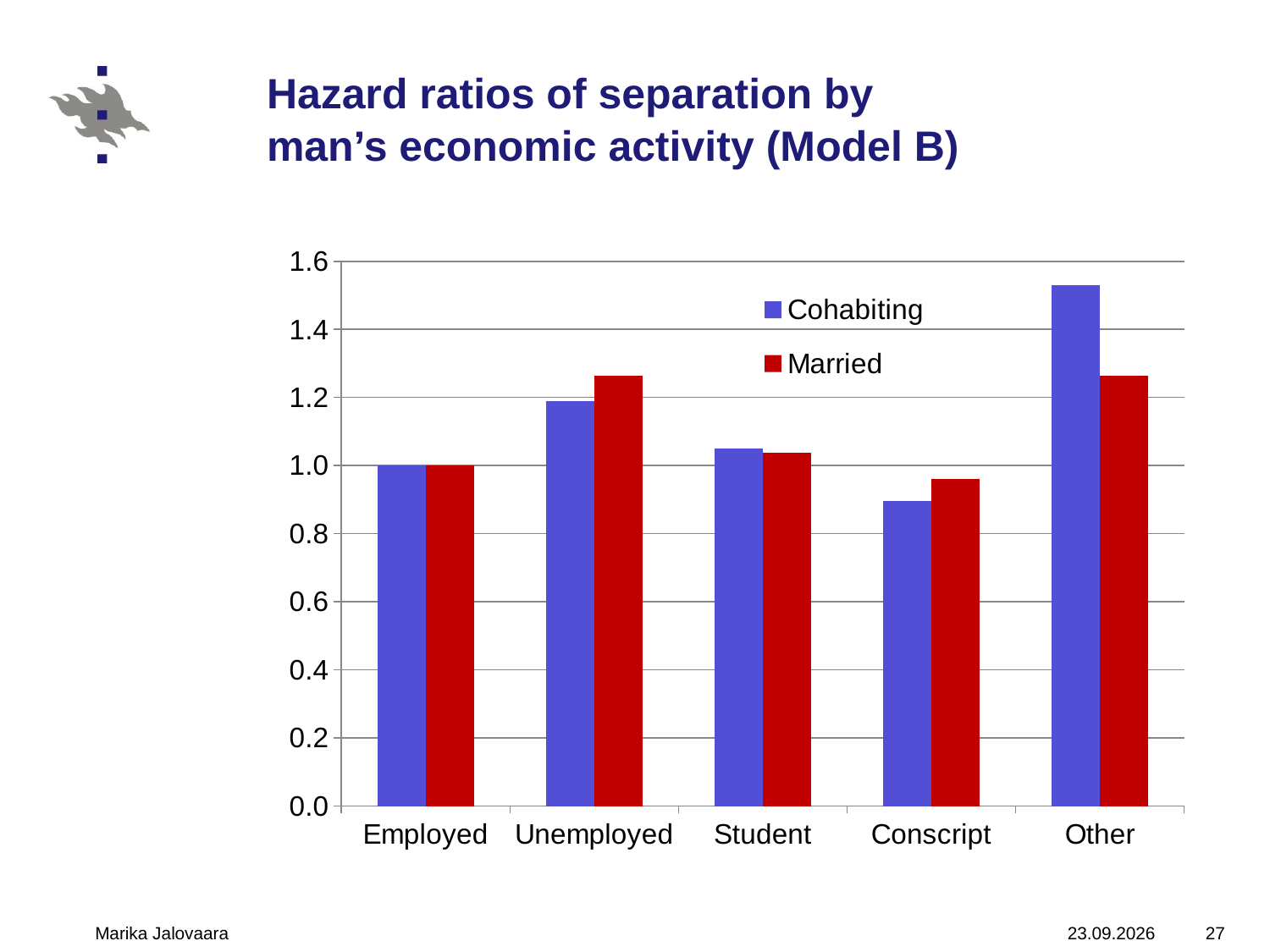
How many series does the legend list? 2 Is the Married value for Conscript greater or less than 1.0? less Is the Married value for Unemployed greater or less than 1.2? greater Which category has the highest Cohabiting hazard ratio? Other Which category has the lowest Cohabiting hazard ratio? Conscript How many economic activity categories are shown on the x axis? 5 What is the title of the slide? Hazard ratios of separation by man's economic activity (Model B) What is the hazard ratio for Cohabiting in the Employed category? 1.0 Is the Cohabiting value for Other greater or less than 1.4? greater In the Other category, which is larger, the Cohabiting or the Married hazard ratio? Cohabiting What kind of chart is shown on the slide? bar chart In the Unemployed category, which is larger, the Cohabiting or the Married hazard ratio? Married